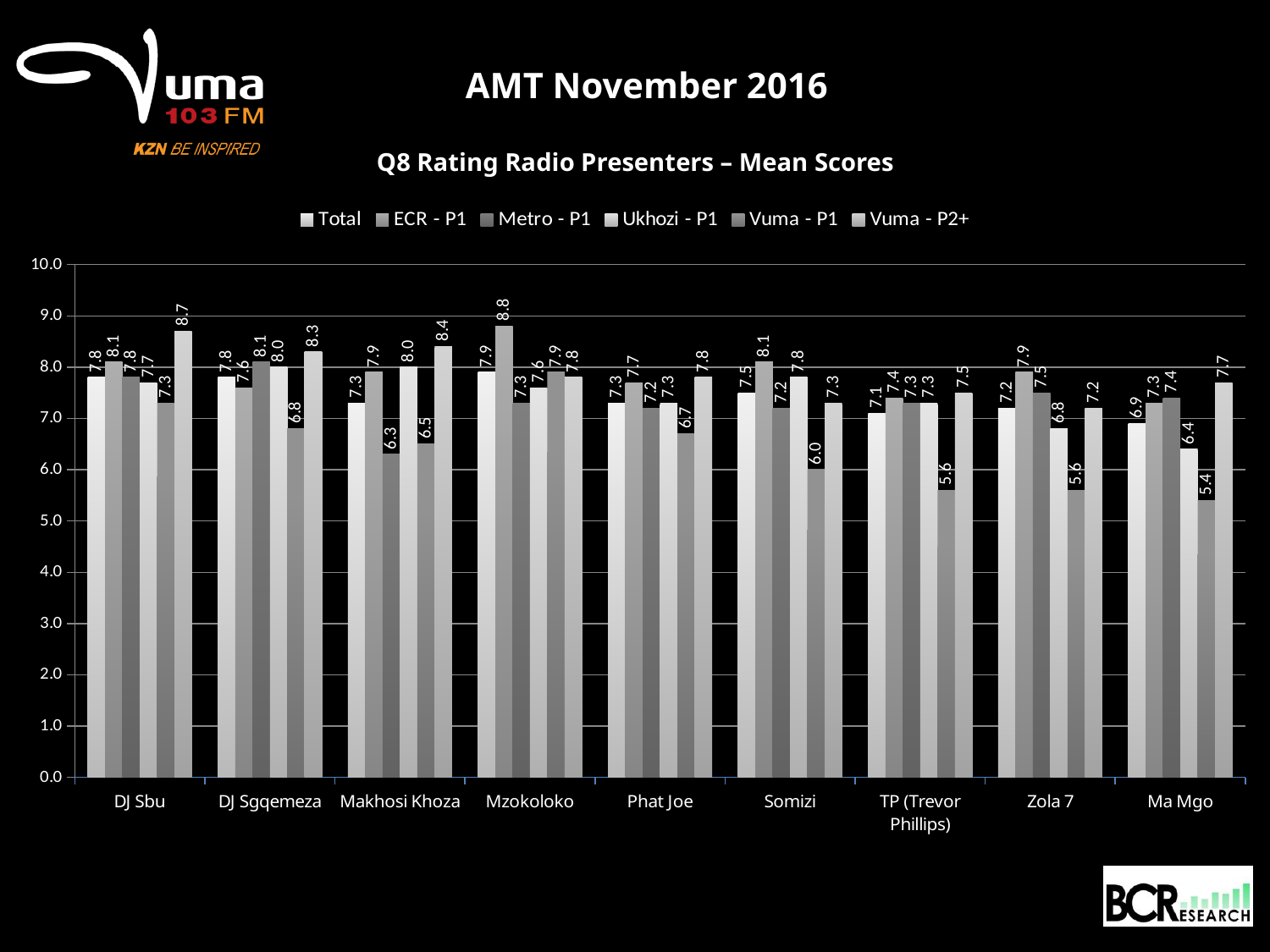
What is the title of the chart? Q8 Rating Radio Presenters – Mean Scores Which is larger for Somizi: the ECR - P1 score or the Vuma - P1 score? ECR - P1 How many series does the legend list? 6 What is the difference between the Vuma - P2+ and Vuma - P1 scores for DJ Sbu? 1.4 What is the Vuma - P2+ mean score for DJ Sbu? 8.7 What kind of chart is shown on the slide? bar chart Which presenter has the lowest Total mean score? Ma Mgo What is the Vuma - P1 mean score for Ma Mgo? 5.4 How many radio presenters are shown on the x axis? 9 Which presenter has the highest ECR - P1 mean score? Mzokoloko Is the Vuma - P1 score for TP (Trevor Phillips) greater or less than 6.0? less What is the Total mean score for Mzokoloko? 7.9